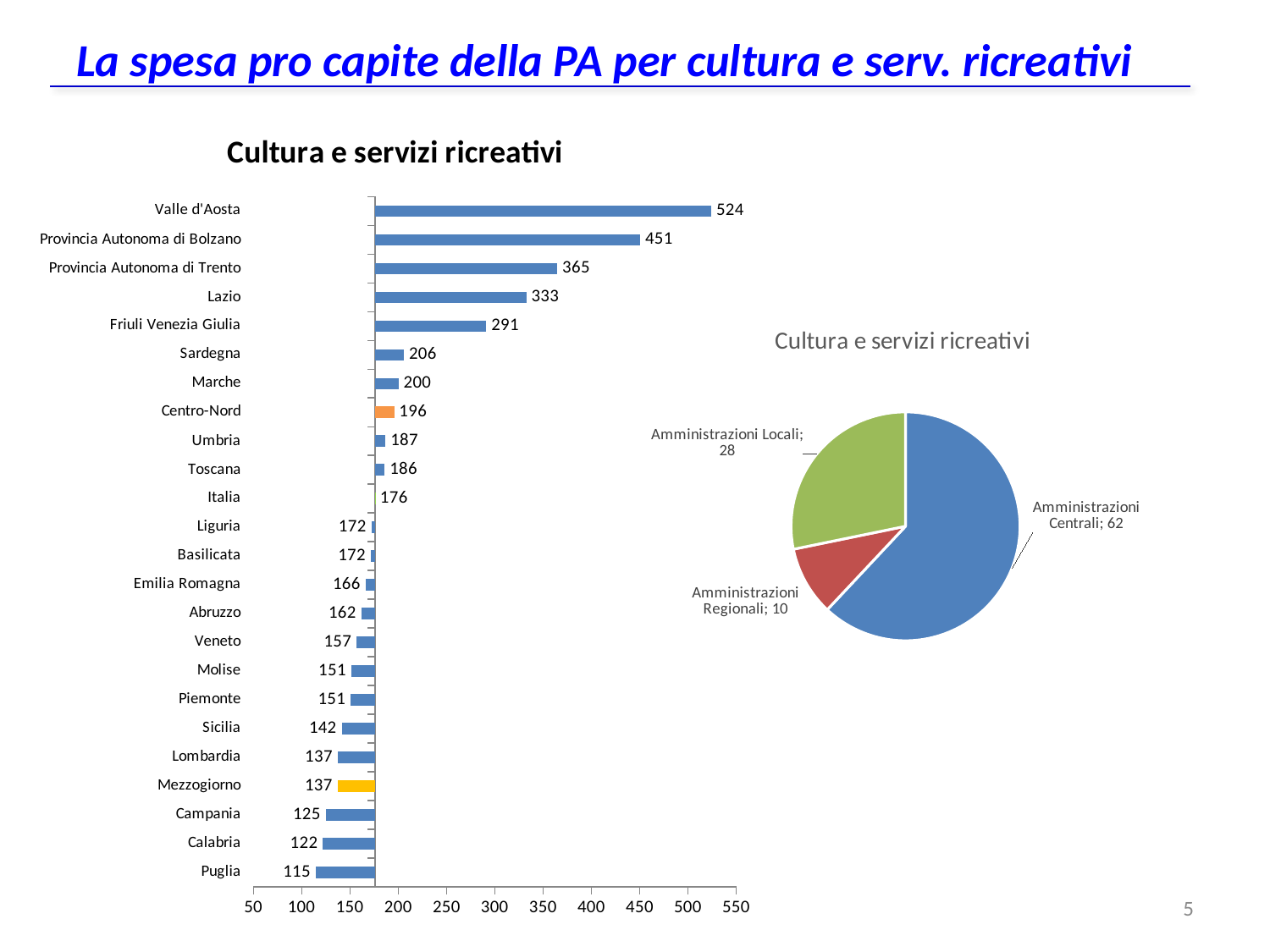
In the bar chart on the left, which category has the highest value? Valle d'Aosta What kind of chart is the chart on the left of the slide? Bar chart In the bar chart on the left, what is the value for Italia? 176 In the bar chart on the left, what is the value for Valle d'Aosta? 524 In the bar chart on the left, what is the difference between the values for Centro-Nord and Mezzogiorno? 59 In the pie chart on the right, which slice is the largest? Amministrazioni Centrali In the bar chart on the left, what is the value for Lazio? 333 In the pie chart on the right, what is the value for Amministrazioni Locali? 28 How many categories are shown in the bar chart on the left? 24 In the pie chart on the right, what share of the total does Amministrazioni Regionali represent? 10% In the bar chart on the left, which is larger, the value for Sardegna or the value for Marche? Sardegna In the bar chart on the left, which category has the lowest value? Puglia